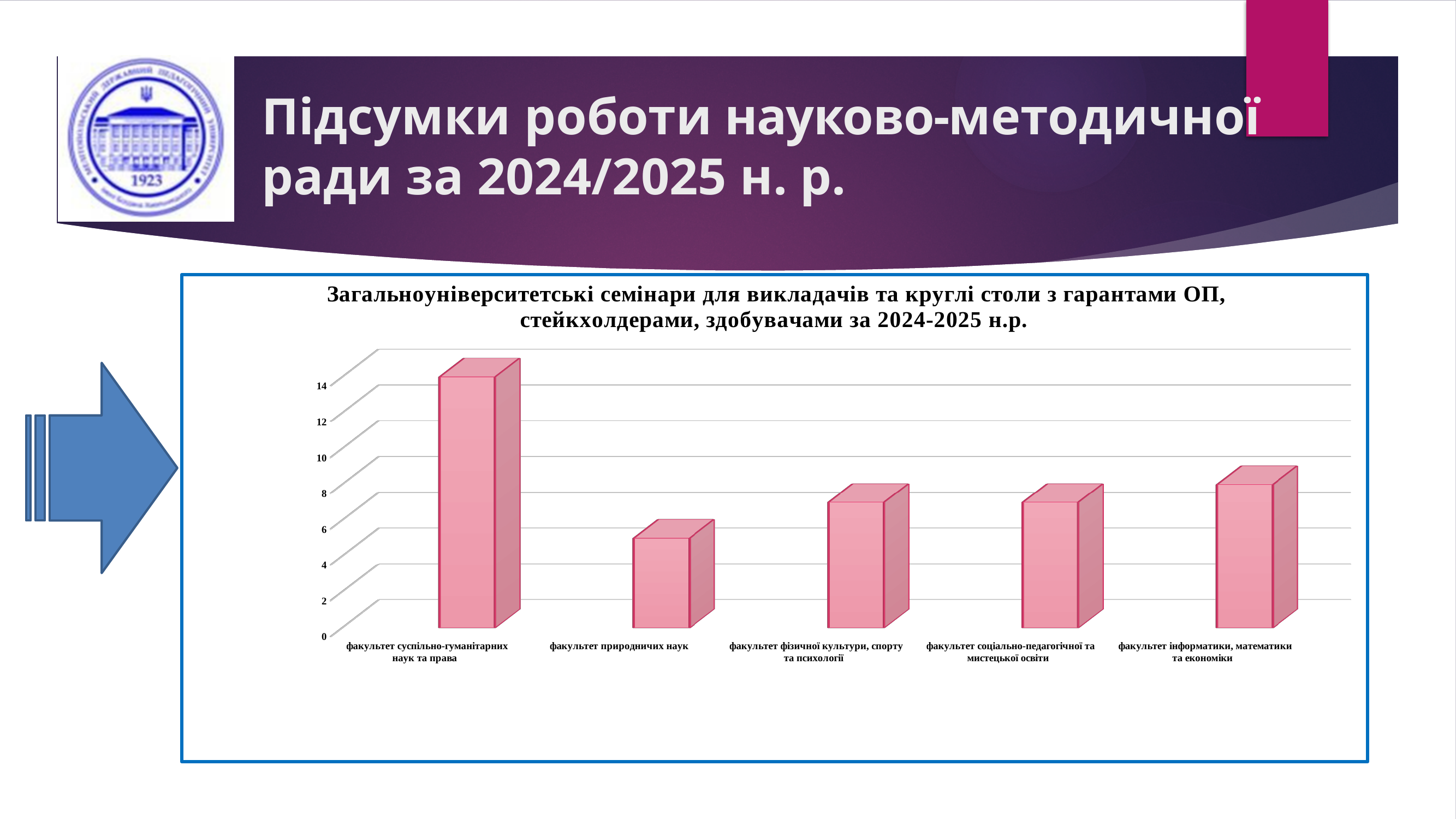
Is the value for факультет інформатики, математики та економіки greater or less than 6? greater Is the value for факультет суспільно-гуманітарних наук та права greater or less than 10? greater Which is larger: the value for факультет суспільно-гуманітарних наук та права or for факультет природничих наук? факультет суспільно-гуманітарних наук та права How many faculties (categories) are shown on the chart? 5 What academic year does the chart title refer to? 2024-2025 н.р. What kind of chart is shown on the slide? bar chart Is the value for факультет фізичної культури, спорту та психології greater or less than 6? greater Which faculty has the lowest bar on the chart? факультет природничих наук Which faculty has the highest bar on the chart? факультет суспільно-гуманітарних наук та права Which is larger: the value for факультет інформатики, математики та економіки or for факультет природничих наук? факультет інформатики, математики та економіки